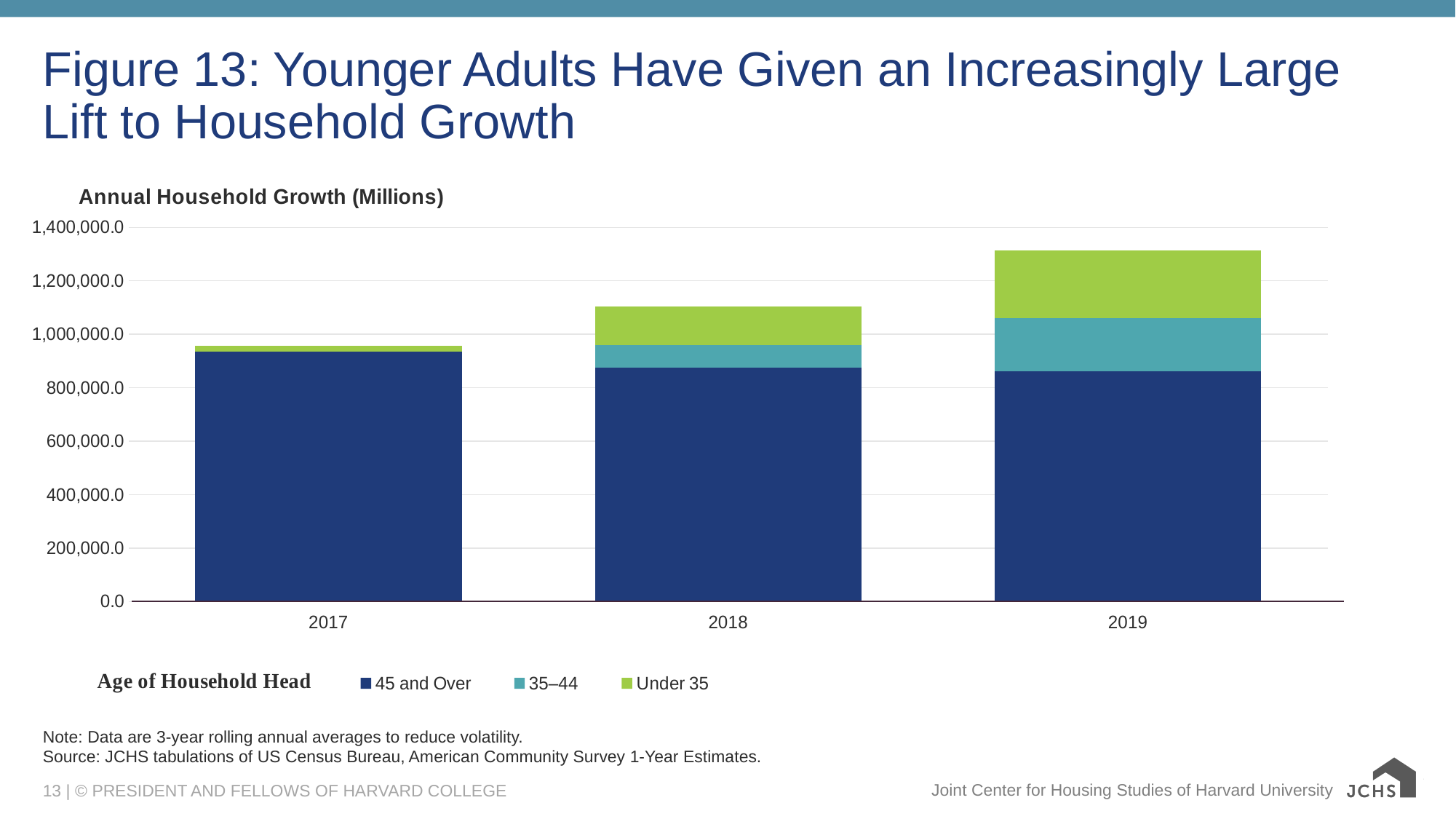
What is the label shown above the chart's vertical axis? Annual Household Growth (Millions) Which year has the tallest total bar? 2019 Which year has the larger Under 35 segment, 2018 or 2019? 2019 How many years are shown on the x axis of the chart? 3 Which year has the shortest total bar? 2017 Do the total bar heights rise or fall from 2017 to 2019? Rise Is the total bar for 2017 greater or less than 1,000,000.0? less How many series does the chart's legend list? 3 What is the title of the chart's legend? Age of Household Head What kind of chart is shown on the slide? Stacked bar chart Is the total bar for 2018 greater or less than 1,000,000.0? greater Is the total bar for 2019 greater or less than 1,200,000.0? greater